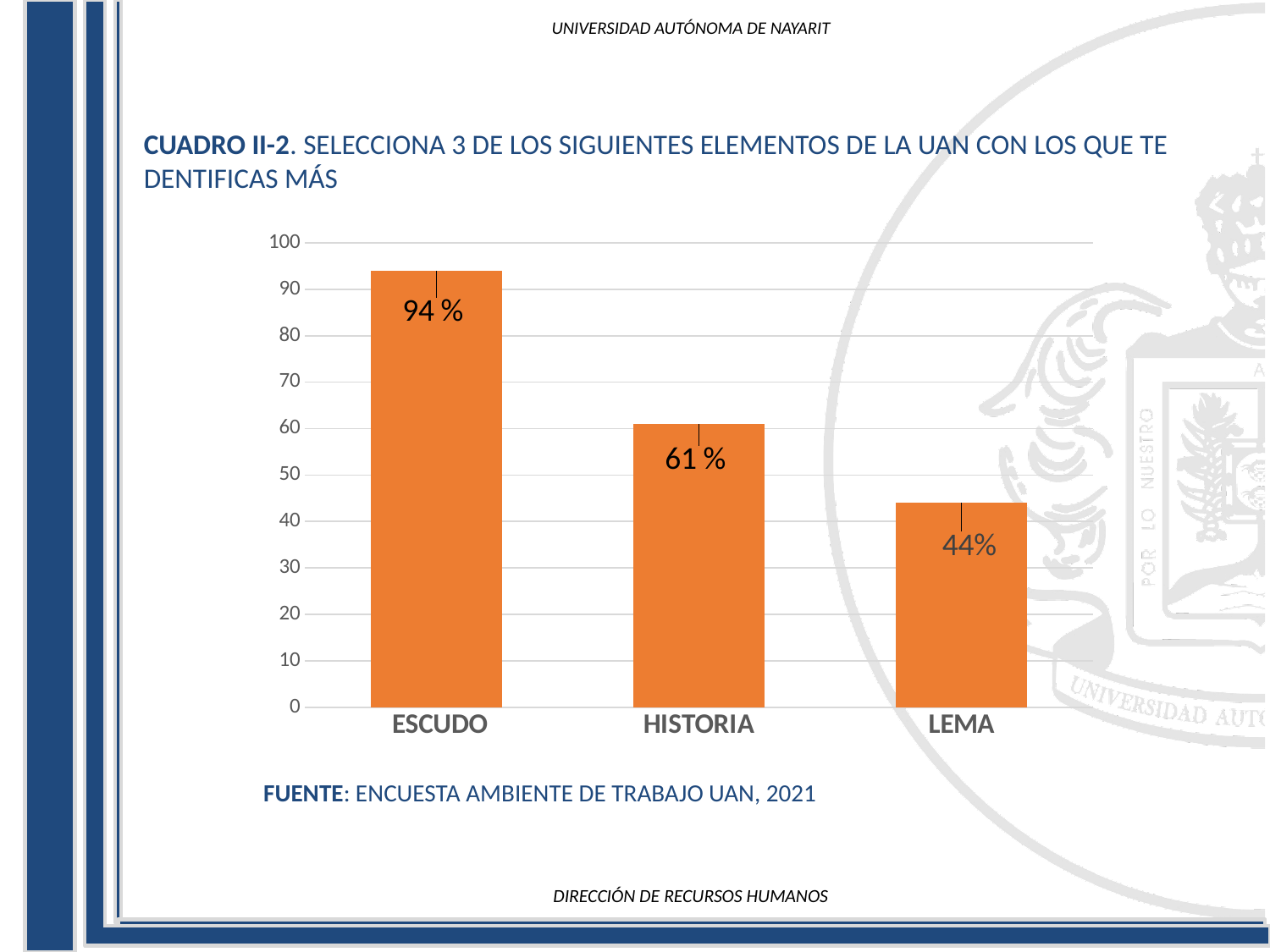
Is the value for LEMA greater or less than 50? less How many categories are shown in the chart? 3 What is the difference between the values for ESCUDO and HISTORIA? 33 Which category has the highest value? ESCUDO Do the values rise or fall from left to right along the x axis? fall What is the difference between the values for HISTORIA and LEMA? 17 What is the value for HISTORIA? 61 % Which category has the lowest value? LEMA What is the value for ESCUDO? 94 % Which is larger, the value for HISTORIA or the value for LEMA? HISTORIA What kind of chart is shown on the slide? bar chart What is the value for LEMA? 44%